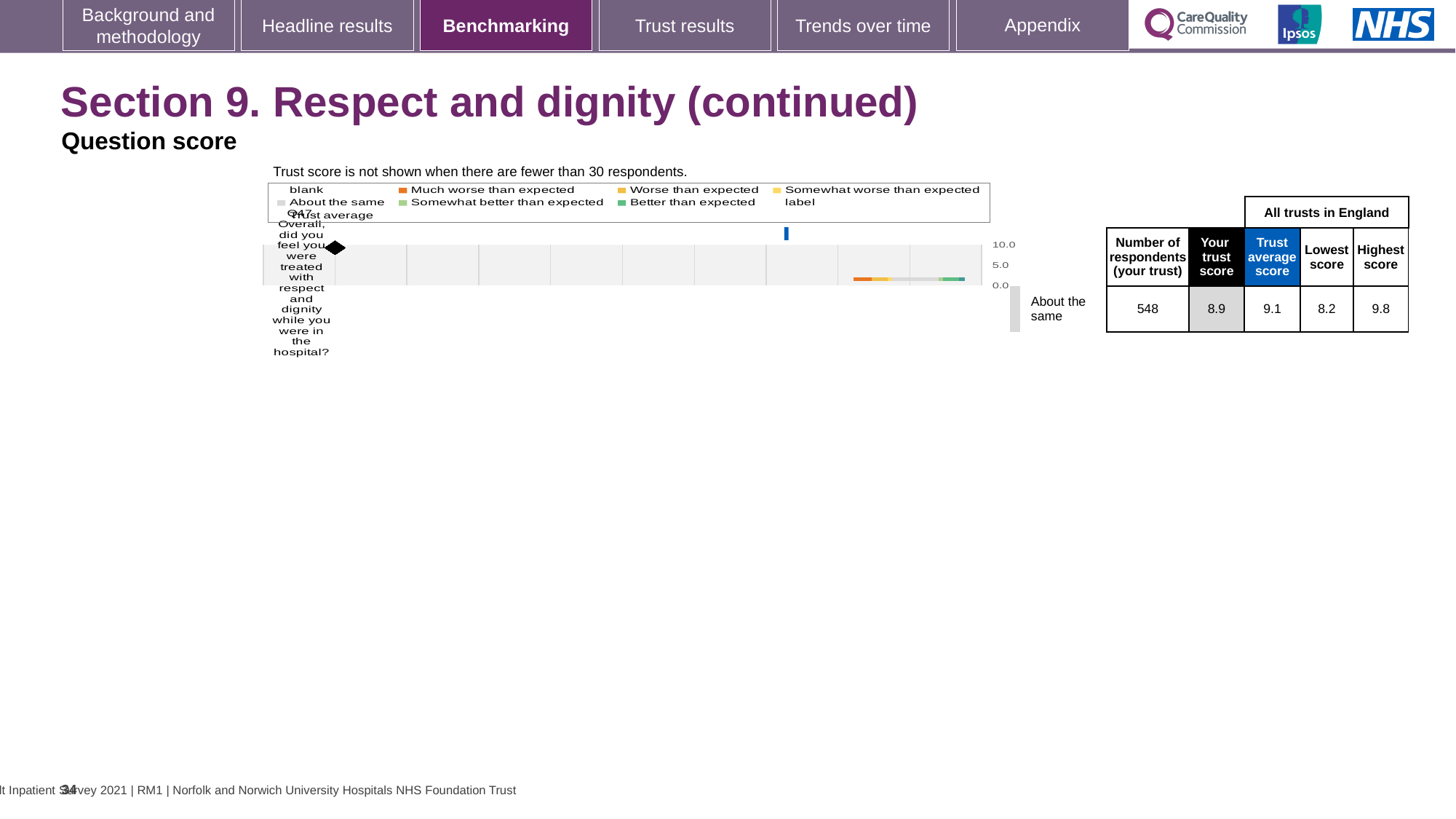
In the table next to the chart, what is the highest score among all trusts in England? 9.8 What is the question number shown for the chart's category? Q47 Which is larger in the table next to the chart: your trust score or the trust average score? Trust average score In the table next to the chart, what is your trust score for Q47? 8.9 What is the highest value shown on the chart's numeric axis? 10.0 Which colour in the chart legend represents 'Much worse than expected'? orange What kind of chart is shown on the slide? bar chart What benchmark rating is shown for Q47 next to the chart? About the same What is the difference between the highest score and the lowest score in the table next to the chart? 1.6 In the table next to the chart, what is the trust average score for all trusts in England? 9.1 In the table next to the chart, what is the number of respondents for your trust? 548 In the table next to the chart, what is the lowest score among all trusts in England? 8.2